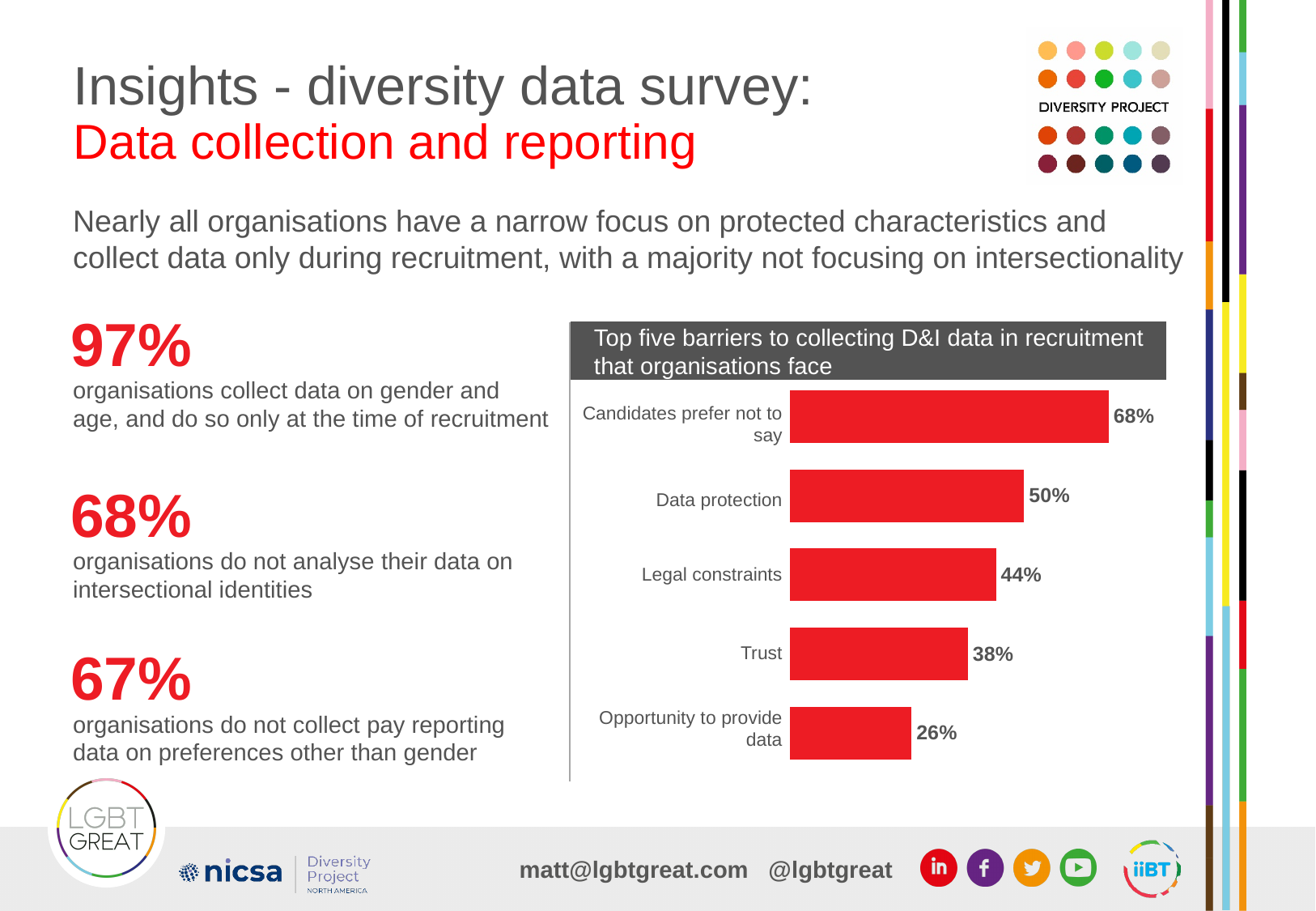
What is the value for Trust? 38% Which barrier has the lowest value? Opportunity to provide data What kind of chart is shown on the slide? Bar chart What is the value for Candidates prefer not to say? 68% What is the value for Legal constraints? 44% What is the value for Data protection? 50% Which is larger, the value for Legal constraints or the value for Trust? Legal constraints How many barriers are shown in the chart? 5 What is the difference between the values for Trust and Opportunity to provide data? 12% What is the difference between the values for Candidates prefer not to say and Data protection? 18% Which barrier has the highest value? Candidates prefer not to say What is the value for Opportunity to provide data? 26%